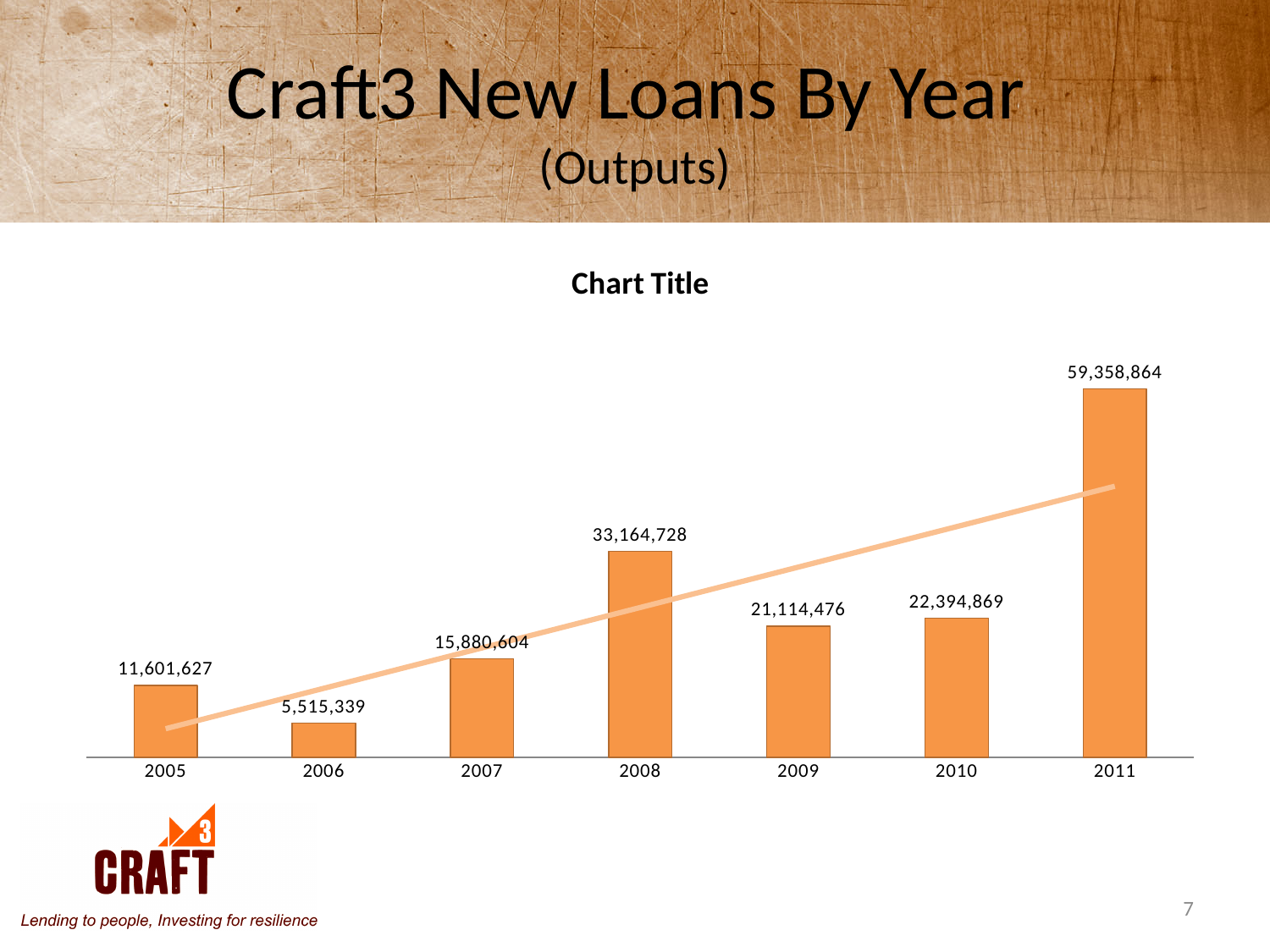
What is the difference between the values for 2011 and 2008? 26,194,136 Which is larger, the value for 2007 or the value for 2009? 2009 Which year has the lowest value? 2006 What kind of chart is this? bar chart How many years are shown on the x axis? 7 What is the value shown for 2006? 5,515,339 What is the value shown for 2011? 59,358,864 Does the trend line drawn across the bars rise or fall from 2005 to 2011? rise What is the value shown for 2009? 21,114,476 Which year has the highest value? 2011 What is the difference between the values for 2005 and 2006? 6,086,288 What is the value shown for 2008? 33,164,728